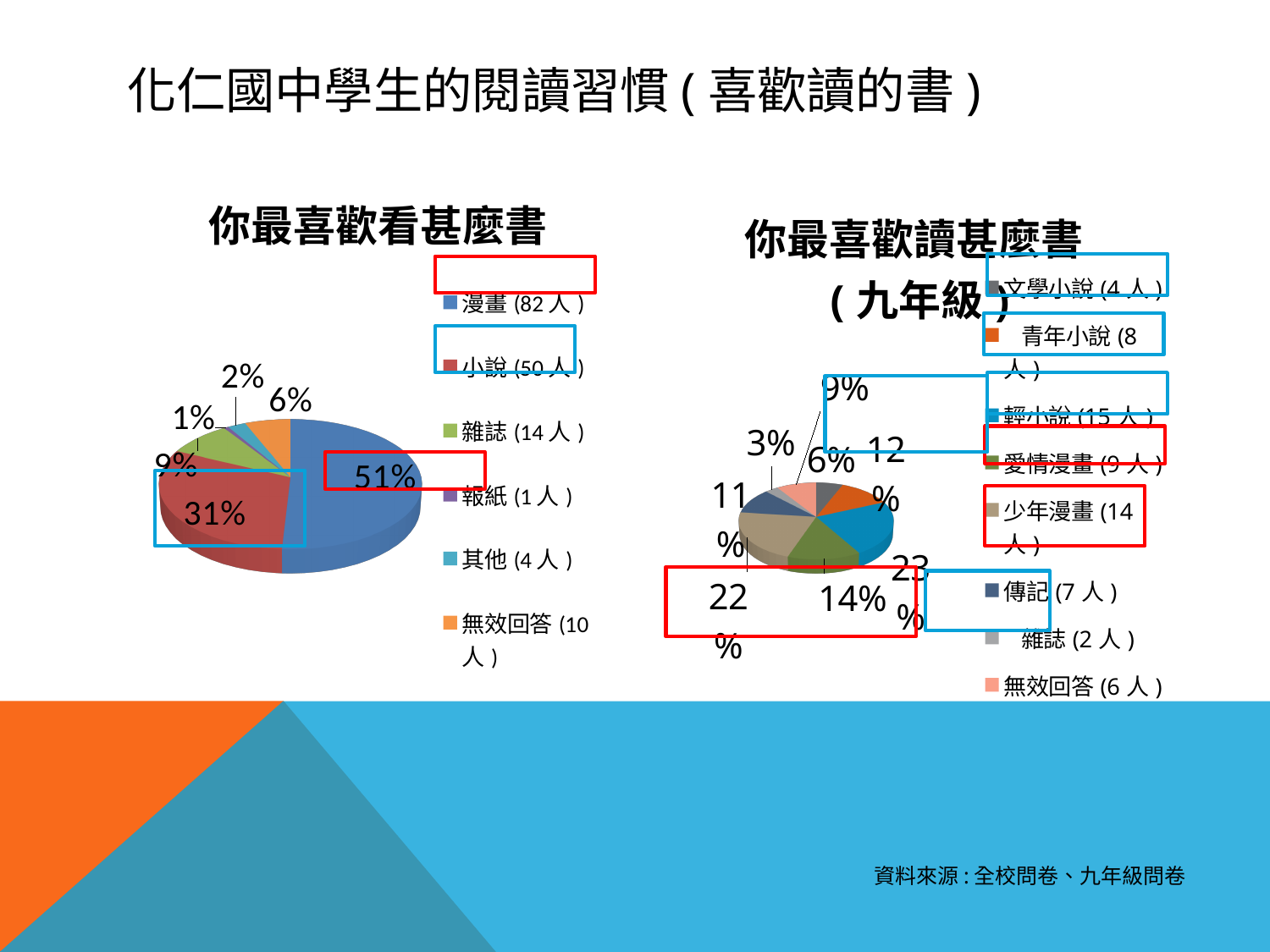
In the left pie chart titled 你最喜歡看甚麼書, what is the difference in percentage points between 漫畫 and 小說? 20 In the left pie chart titled 你最喜歡看甚麼書, what percentage is shown for 漫畫? 51% In the left pie chart titled 你最喜歡看甚麼書, how many people chose 雜誌 according to the legend? 14 人 What type of chart is the right chart titled 你最喜歡讀甚麼書(九年級)? Pie chart In the right pie chart titled 你最喜歡讀甚麼書(九年級), which is larger, the share for 少年漫畫 or the share for 愛情漫畫? 少年漫畫 In the left pie chart titled 你最喜歡看甚麼書, which category has the smallest share? 報紙 In the left pie chart titled 你最喜歡看甚麼書, what percentage is shown for 小說? 31% In the right pie chart titled 你最喜歡讀甚麼書(九年級), how many people chose 輕小說 according to the legend? 15 人 In the left pie chart titled 你最喜歡看甚麼書, which category has the largest share? 漫畫 In the right pie chart titled 你最喜歡讀甚麼書(九年級), which category has the largest share? 輕小說 How many categories does the legend of the right pie chart titled 你最喜歡讀甚麼書(九年級) list? 8 How many categories does the legend of the left pie chart titled 你最喜歡看甚麼書 list? 6